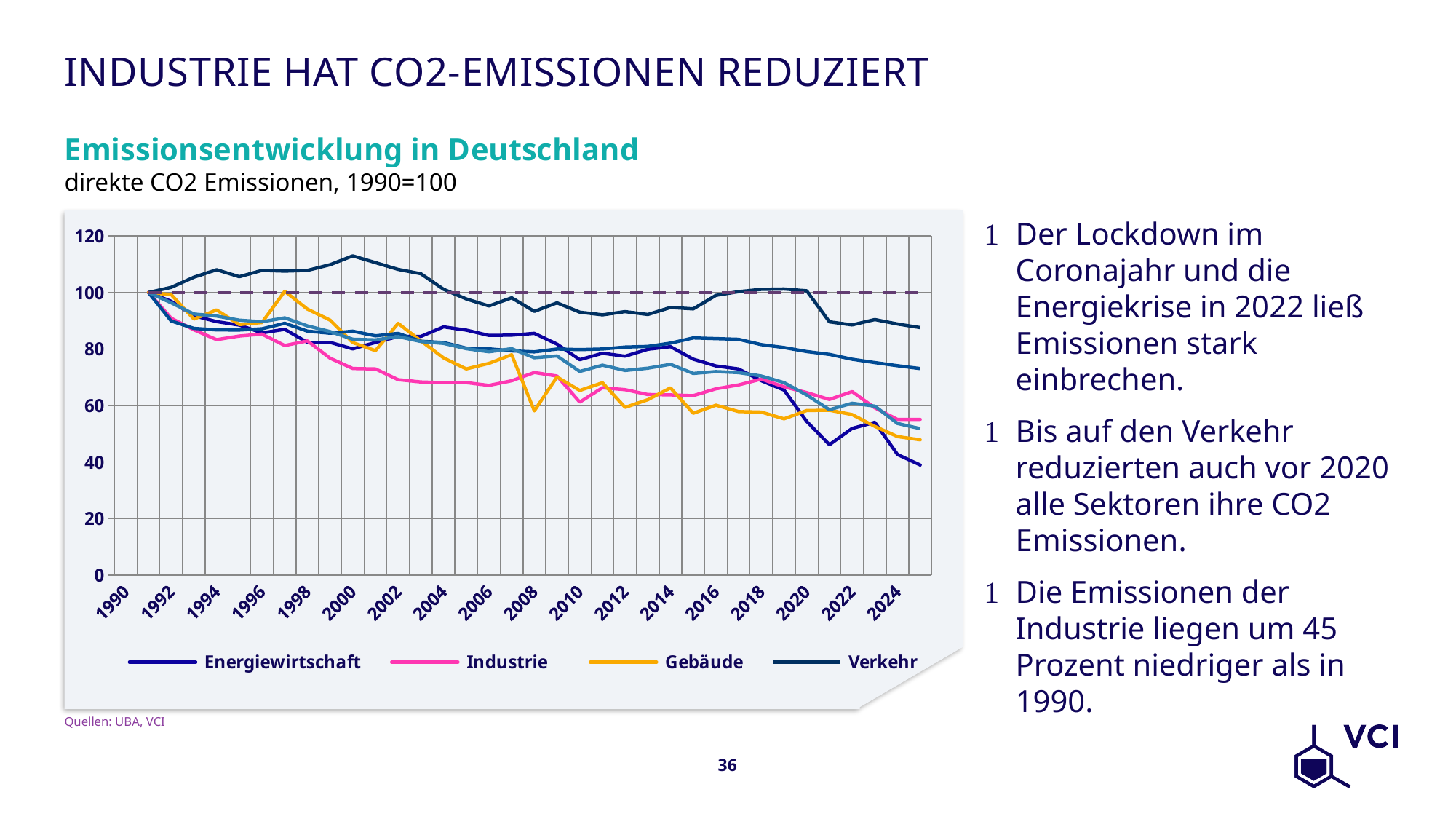
What is the title of the chart? Emissionsentwicklung in Deutschland Is the value for Verkehr in 2000 greater or less than 100? greater Which series has the lowest value in 2024? Energiewirtschaft Is the value for Gebäude in 2024 greater or less than 60? less What is the value of the Industrie series in 1990? 100 Which series has the highest value in 2024? Verkehr How many series does the chart legend list? 4 Is the value for Verkehr in 2024 greater or less than 80? greater Does the Industrie series rise or fall overall from 1990 to 2024? fall What kind of chart is shown on the slide? line chart In 2024, which is larger: the value for Verkehr or the value for Industrie? Verkehr